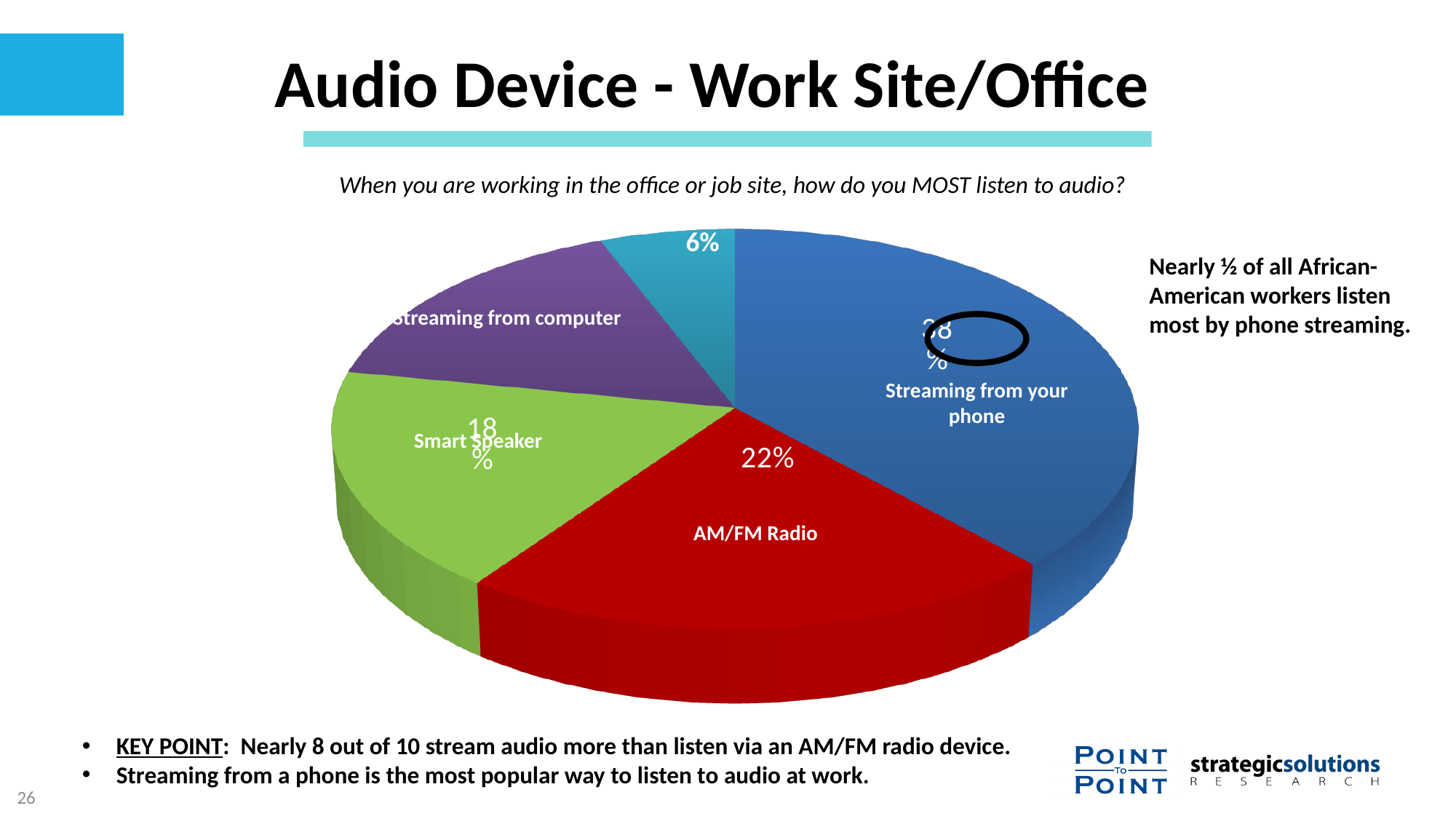
What type of chart is shown on the slide? Pie chart Is the Streaming from your phone slice greater or less than 25% of the pie? greater What percentage is shown for the Smart Speaker slice? 18% How many slices does the pie chart have? 5 What survey question is shown above the pie chart? When you are working in the office or job site, how do you MOST listen to audio? Which category has the largest slice of the pie? Streaming from your phone How many percentage points larger is AM/FM Radio than Smart Speaker? 4 What share of the pie does AM/FM Radio represent? 22% Which is larger, the AM/FM Radio slice or the Smart Speaker slice? AM/FM Radio What percentage of respondents listen most via AM/FM Radio? 22% What colour is the AM/FM Radio slice? Red What is the percentage printed on the smallest slice of the pie? 6%